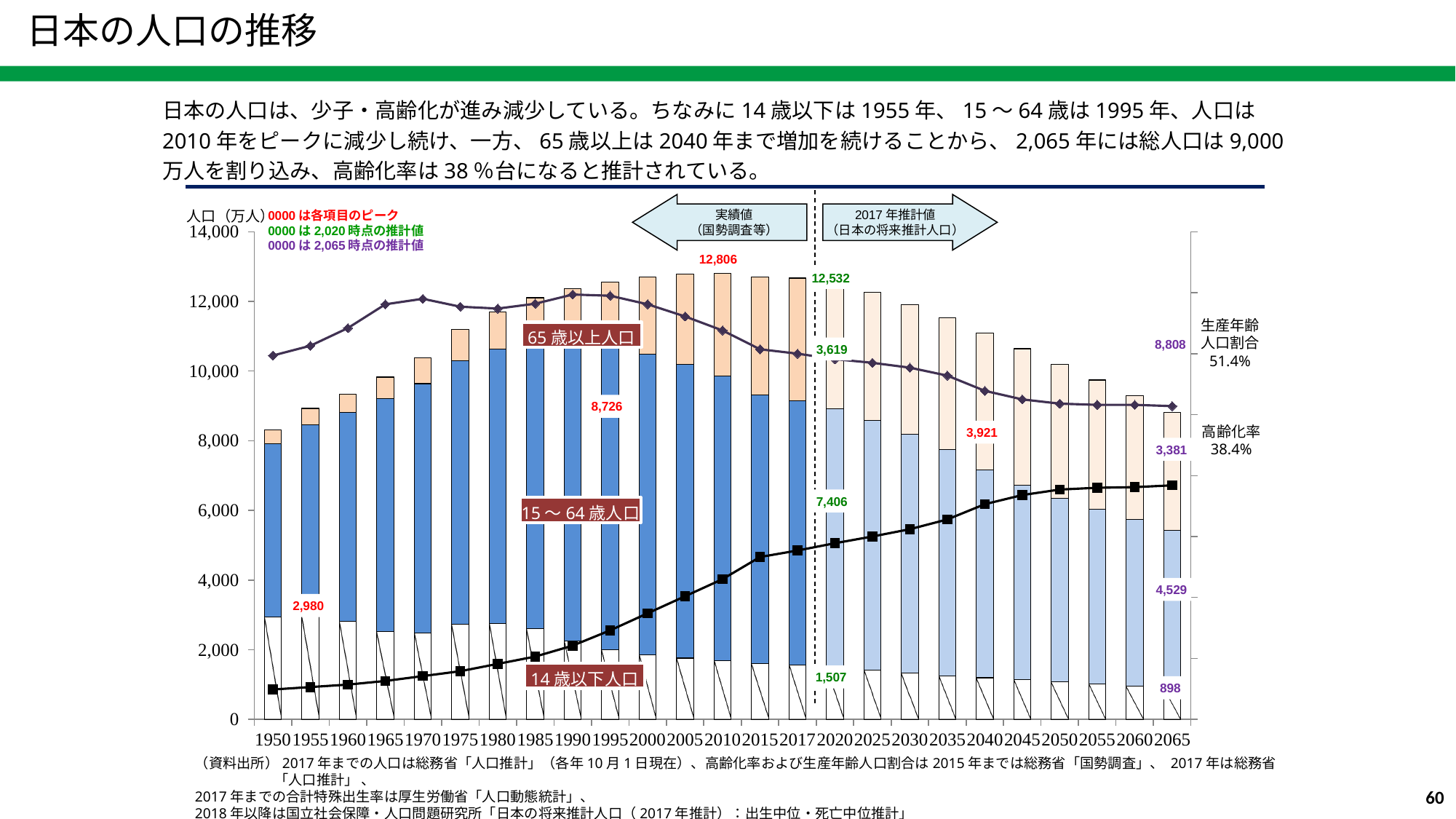
Which is larger, the 15～64歳人口 value for 2020 or for 2065? 2020 How many years are shown on the x axis? 25 What is the total population value labelled for 2020? 12,532 Does the 高齢化率 line rise or fall from 1950 to 2065? rises Is the total population for 1950 greater or less than 10,000? less What is the 15～64歳人口 value labelled for 2020? 7,406 What is the difference between the total population labelled for 2020 and for 2065? 3,724 What is the 14歳以下人口 value labelled for 2065? 898 What is the total population value labelled for 2065? 8,808 What is the 65歳以上人口 value labelled for 2065? 3,381 What is the peak value labelled for 14歳以下人口? 2,980 What is the 高齢化率 shown for 2065? 38.4%